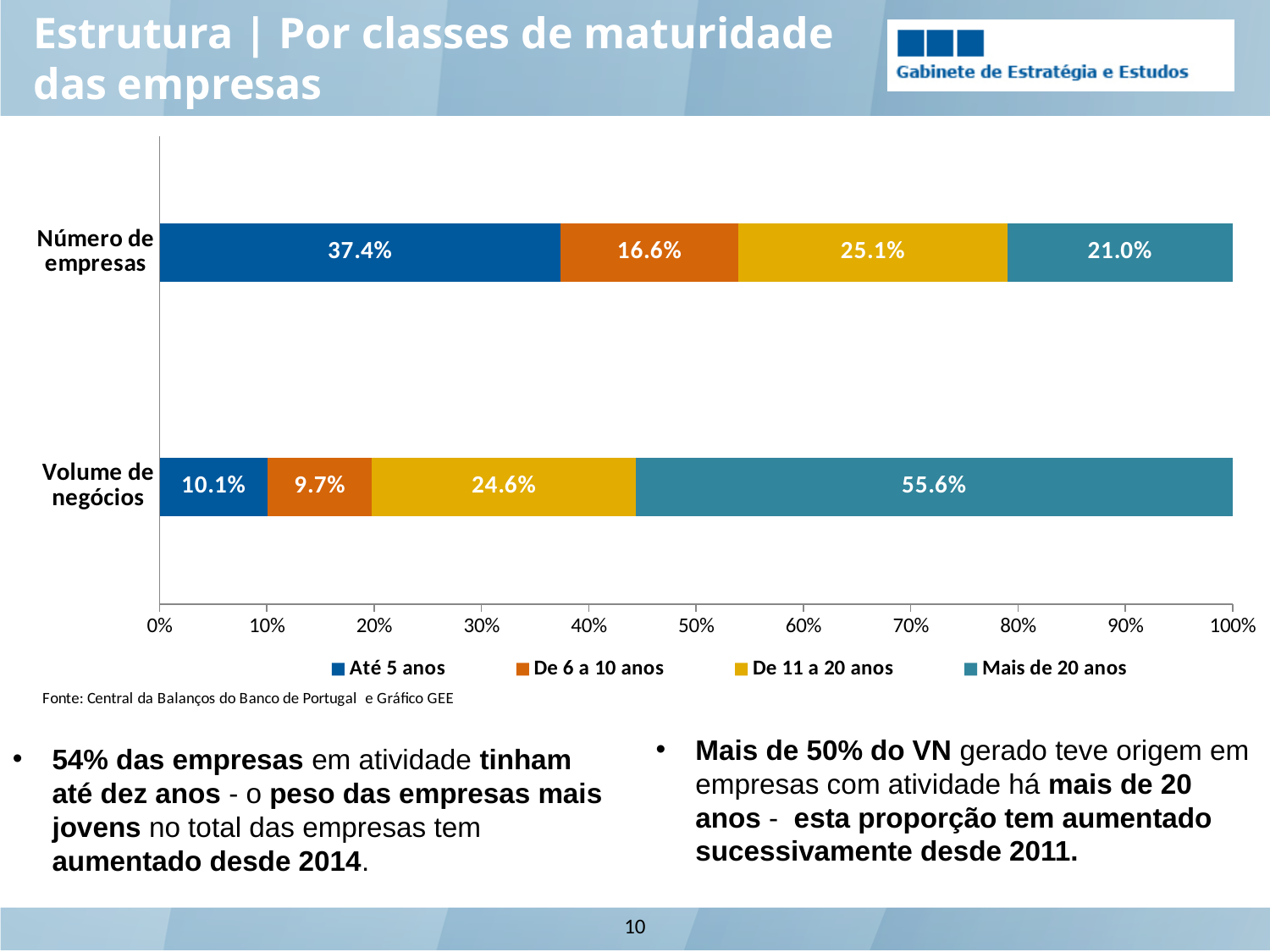
Which maturity class has the smallest share in the 'Volume de negócios' bar? De 6 a 10 anos What is the value for 'Até 5 anos' in the 'Número de empresas' bar? 37.4% Which is larger: the 'De 6 a 10 anos' share in 'Número de empresas' or in 'Volume de negócios'? Número de empresas How many series does the legend list? 4 What is the difference between the 'Mais de 20 anos' share in 'Volume de negócios' and in 'Número de empresas'? 34.6 percentage points What is the value for 'De 11 a 20 anos' in the 'Volume de negócios' bar? 24.6% How many categories (bars) are shown on the chart? 2 What is the source cited below the chart? Central da Balanços do Banco de Portugal e Gráfico GEE What is the combined share of 'Até 5 anos' and 'De 6 a 10 anos' in the 'Número de empresas' bar? 54.0% What is the value for 'Mais de 20 anos' in the 'Volume de negócios' bar? 55.6% What kind of chart is shown on the slide? Stacked bar chart Which maturity class has the largest share in the 'Número de empresas' bar? Até 5 anos